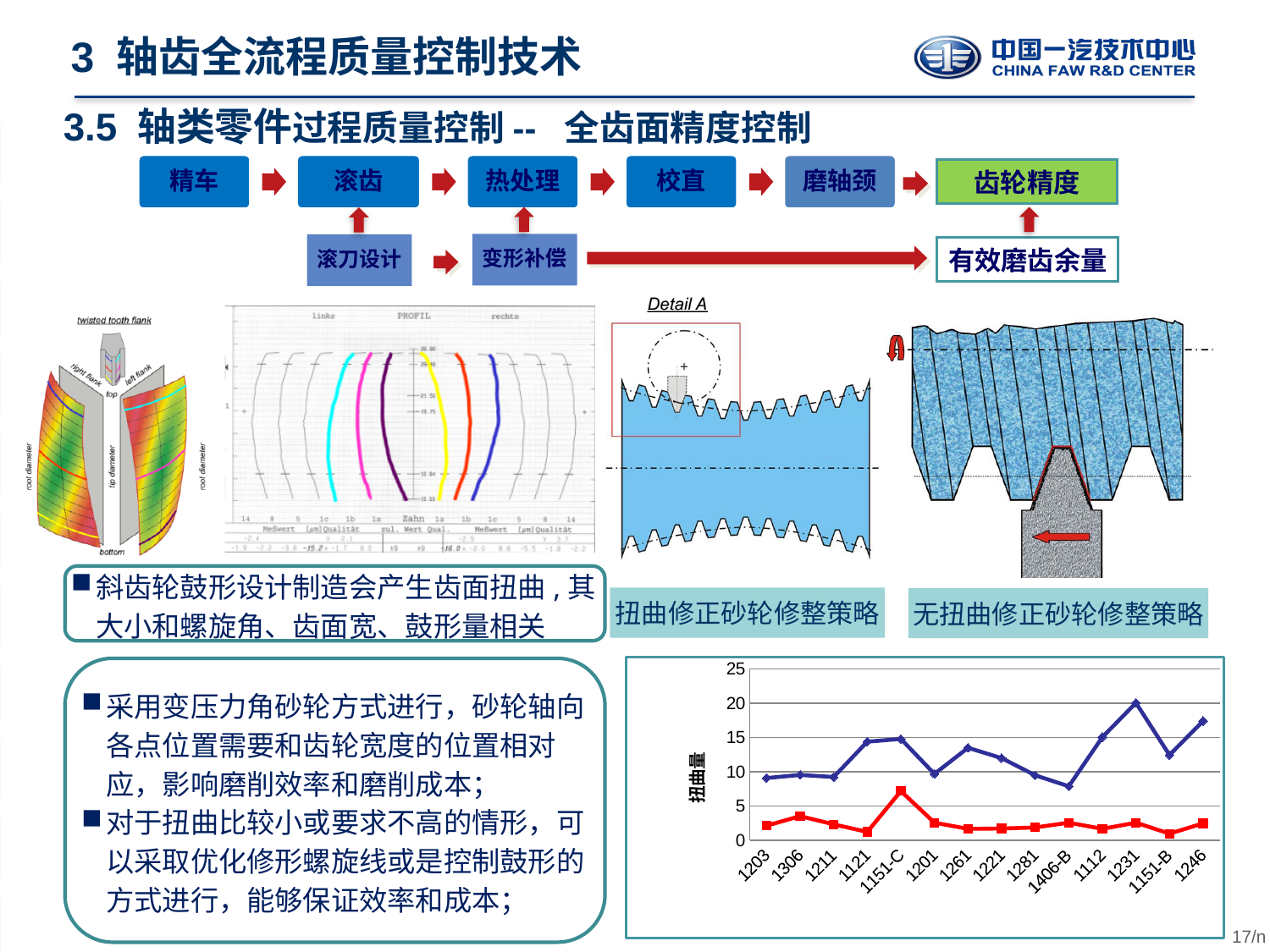
In the line chart at the bottom right, which category has the lowest value on the blue line? 1406-B In the line chart at the bottom right, which category has the highest value on the red line? 1151-C How many categories are shown on the x axis of the line chart at the bottom right? 14 In the line chart at the bottom right, is the red line's value for 1151-C greater or less than 5? greater What kind of chart is shown at the bottom right of the slide? line chart In the line chart at the bottom right, is the red line's value for 1203 greater or less than 5? less What is the label on the y axis of the line chart at the bottom right? 扭曲量 In the line chart at the bottom right, is the blue line's value for 1406-B greater or less than 10? less How many data series (lines) are plotted in the line chart at the bottom right? 2 In the line chart at the bottom right, which category has the highest value on the blue line? 1231 In the line chart at the bottom right, which line has the larger value at 1246, the blue line or the red line? the blue line